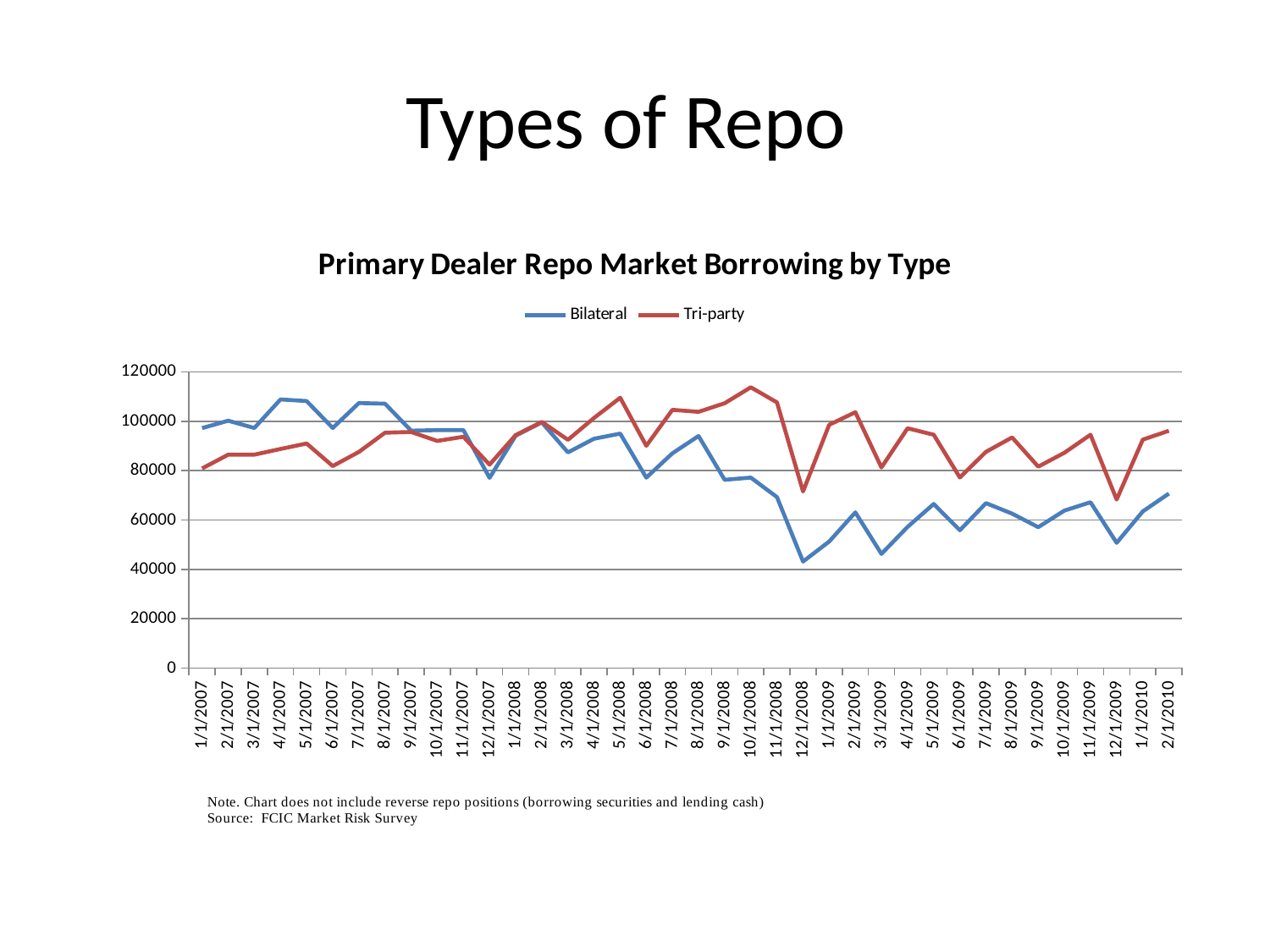
How many dates are shown on the x axis? 38 Is the Bilateral value for 12/1/2008 greater or less than 60000? less At 12/1/2008, which series has the larger value, Bilateral or Tri-party? Tri-party Overall, does the Bilateral series rise or fall from 1/1/2007 to 2/1/2010? Fall Is the Bilateral value for 4/1/2007 greater or less than 100000? greater What is the title of the chart? Primary Dealer Repo Market Borrowing by Type Is the Tri-party value for 10/1/2008 greater or less than 100000? greater How many series does the legend list? 2 Which series is drawn in red? Tri-party What kind of chart is shown on the slide? Line chart At 4/1/2007, which series has the larger value, Bilateral or Tri-party? Bilateral